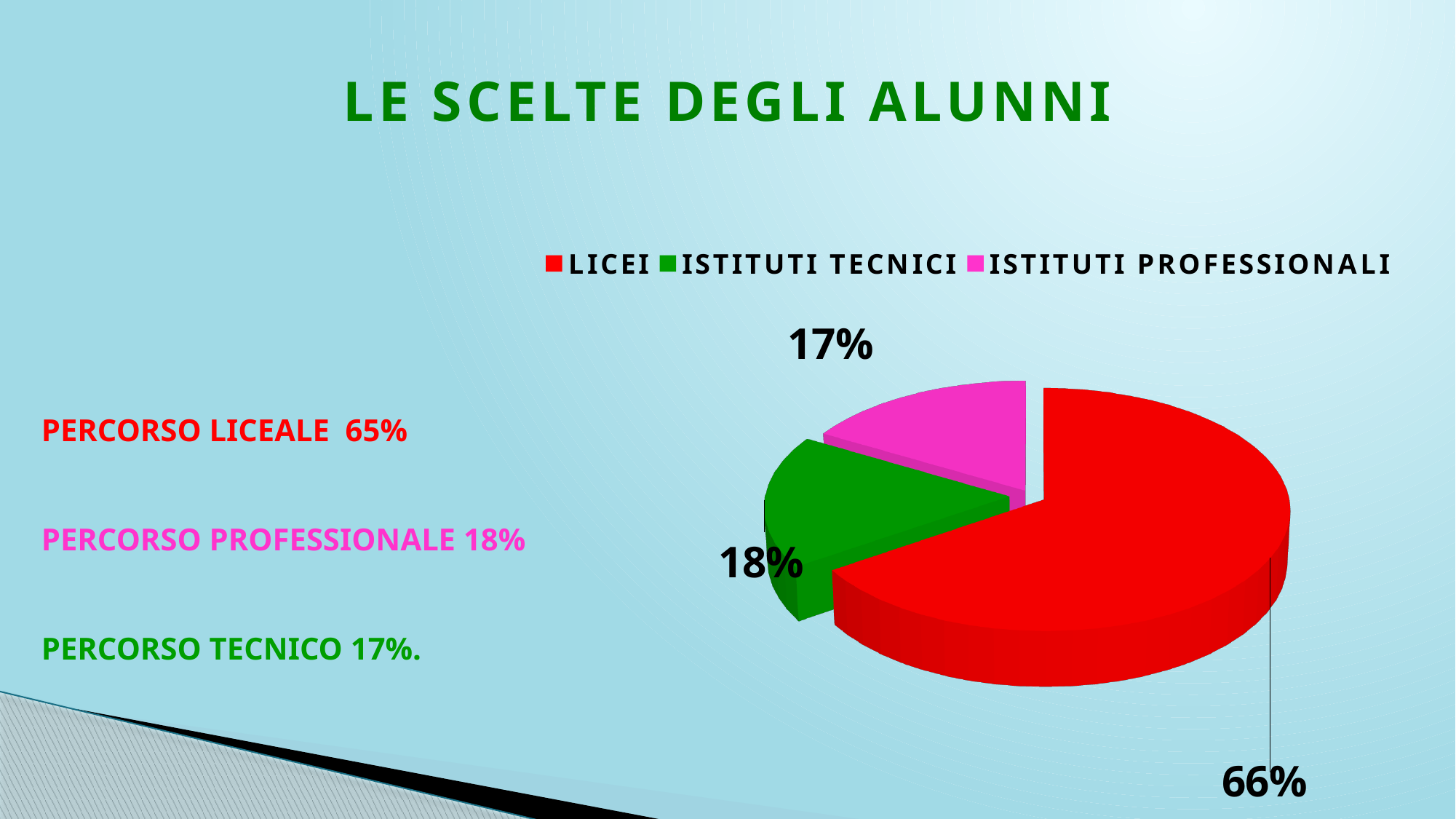
What is the difference in percentage points between the LICEI slice and the ISTITUTI TECNICI slice? 48 What type of chart is shown on the slide? Pie chart How many entries does the chart legend list? 3 What percentage does the pie chart show for LICEI? 66% What percentage does the pie chart show for ISTITUTI TECNICI? 18% What is the title of the chart on the slide? LE SCELTE DEGLI ALUNNI What percentage does the pie chart show for ISTITUTI PROFESSIONALI? 17% Which is larger in the pie chart, LICEI or ISTITUTI TECNICI? LICEI How many slices does the pie chart have? 3 What colour is the LICEI slice in the pie chart? Red Which category has the smallest slice in the pie chart? ISTITUTI PROFESSIONALI Which category has the largest slice in the pie chart? LICEI